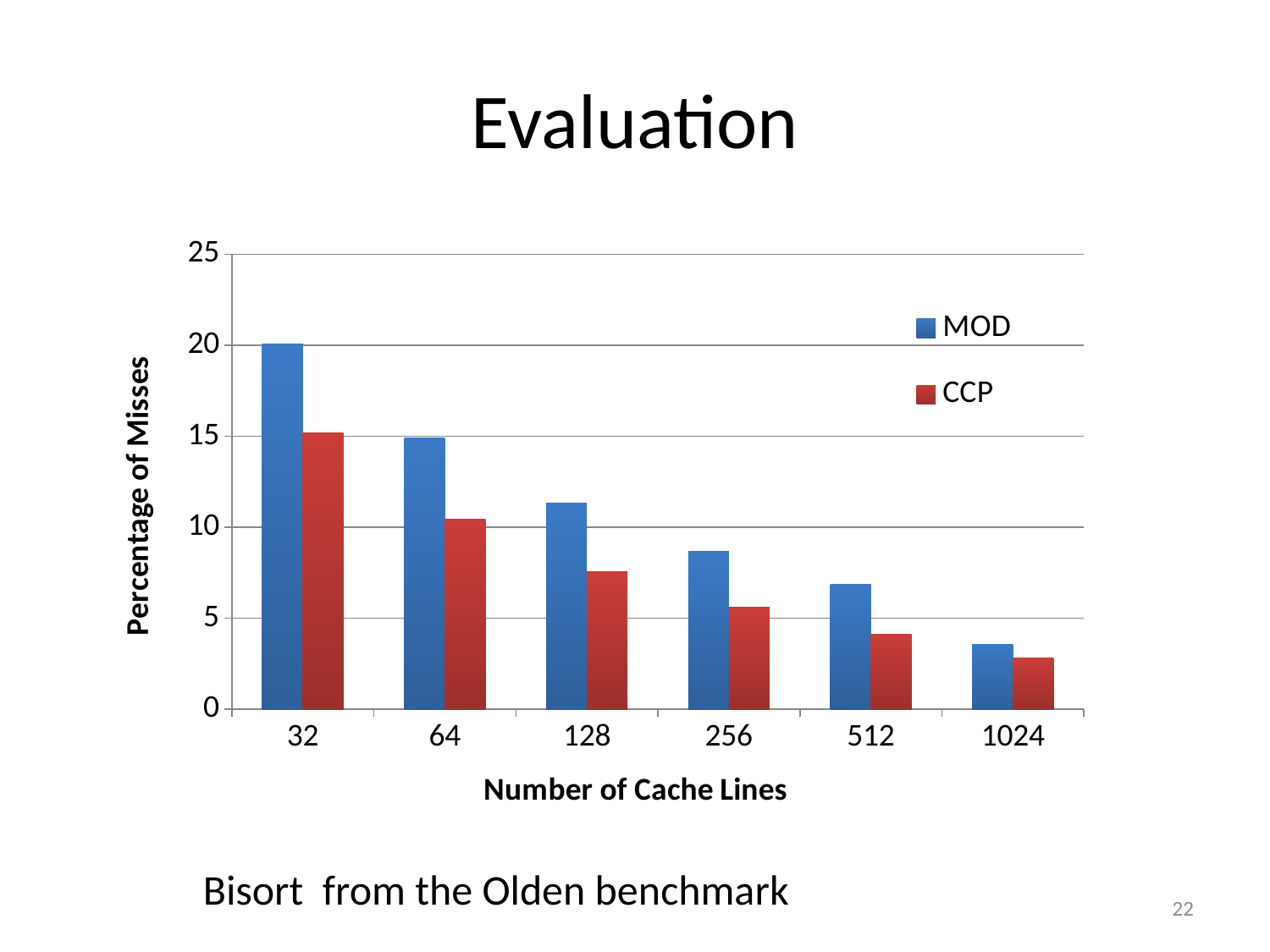
At which number of cache lines is the CCP percentage of misses lowest? 1024 How many series does the legend list? 2 Is the CCP value at 512 cache lines greater or less than 5? less Is the MOD value at 128 cache lines greater or less than 10? greater At which number of cache lines is the MOD percentage of misses highest? 32 Is the MOD value at 256 cache lines greater or less than 10? less How many cache line categories are shown on the x axis? 6 What kind of chart is shown on the slide? bar chart At 32 cache lines, which series has the larger percentage of misses, MOD or CCP? MOD What is the title of the y axis? Percentage of Misses Do the MOD values rise or fall as the number of cache lines increases? fall Which series has the highest bar in the chart? MOD